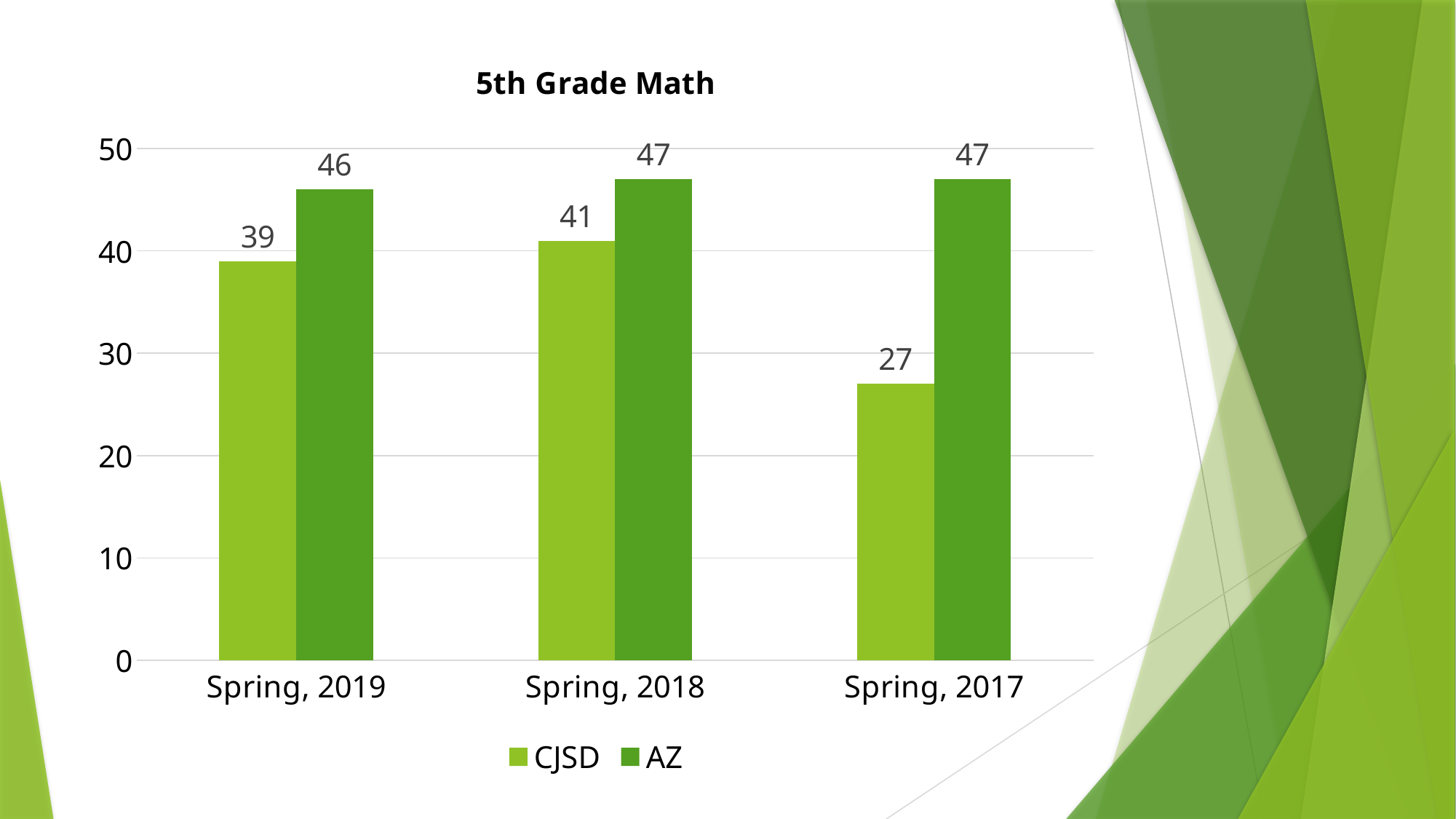
What is the title of the chart? 5th Grade Math Which category has the lowest CJSD value? Spring, 2017 Which is larger for Spring, 2018: the CJSD value or the AZ value? AZ What is the difference between the AZ and CJSD values for Spring, 2017? 20 What is the CJSD value for Spring, 2019? 39 What kind of chart is shown on the slide? Bar chart What is the CJSD value for Spring, 2018? 41 How many categories are shown on the x axis? 3 What is the difference between the AZ and CJSD values for Spring, 2019? 7 Which category has the highest CJSD value? Spring, 2018 How many series does the legend list? 2 What is the AZ value for Spring, 2017? 47